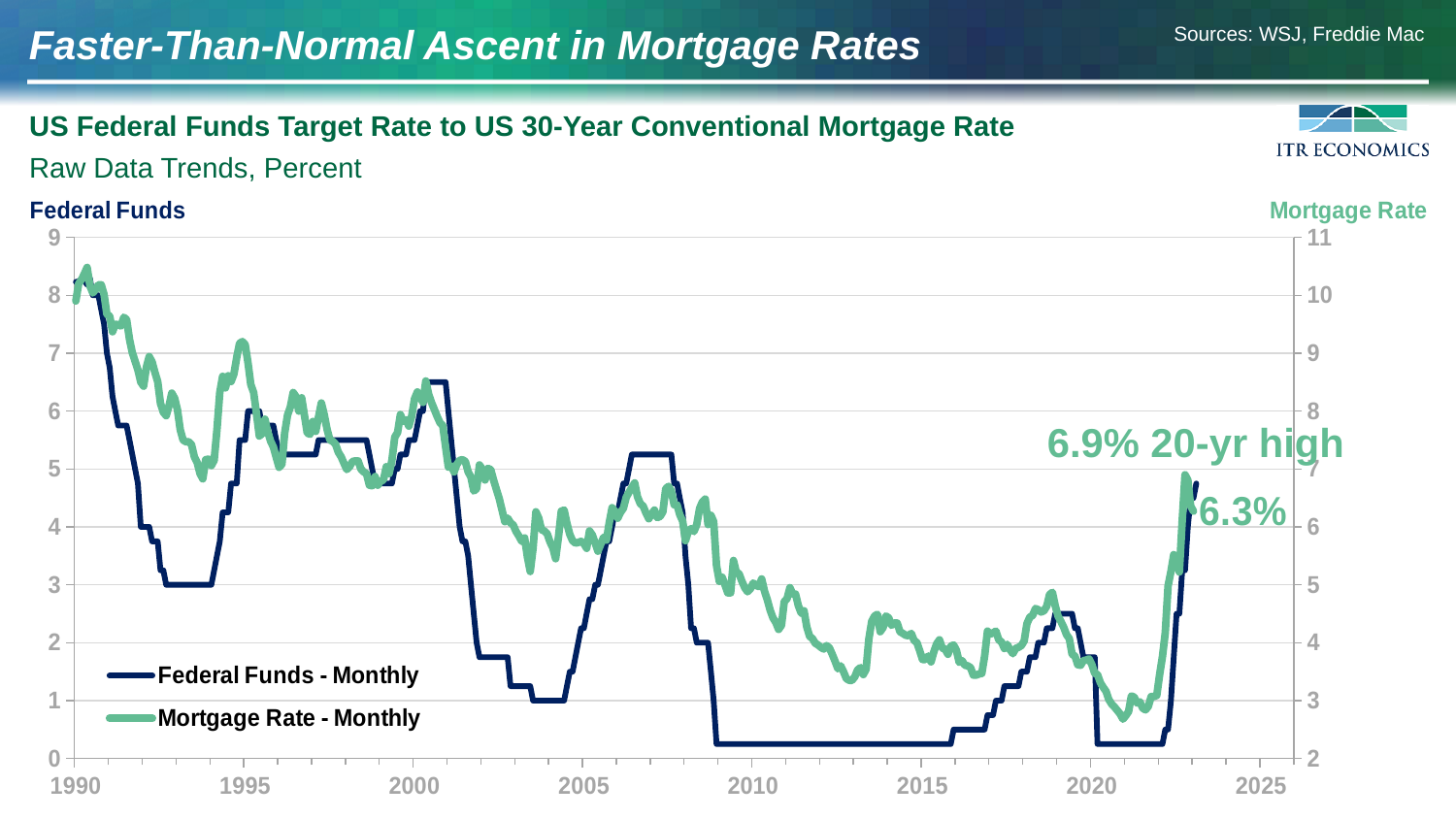
Is the Federal Funds rate in 2010 greater or less than 1? less Which is higher, the Federal Funds rate in 2000 or in 2010? 2000 What is the other value annotated near the end of the Mortgage Rate line, below the 20-yr high label? 6.3% Is the Federal Funds rate in 1993 greater or less than 4? less Is the Federal Funds rate at the start of 1990 greater or less than 7? greater How many series does the chart legend list? 2 Does the Federal Funds rate rise or fall between 1990 and 1993? fall What value is annotated on the chart as the 20-yr high? 6.9% Which axis label appears on the right side of the chart? Mortgage Rate What kind of chart is shown on the slide? line chart Does the Mortgage Rate rise or fall between 2021 and 2023? rise